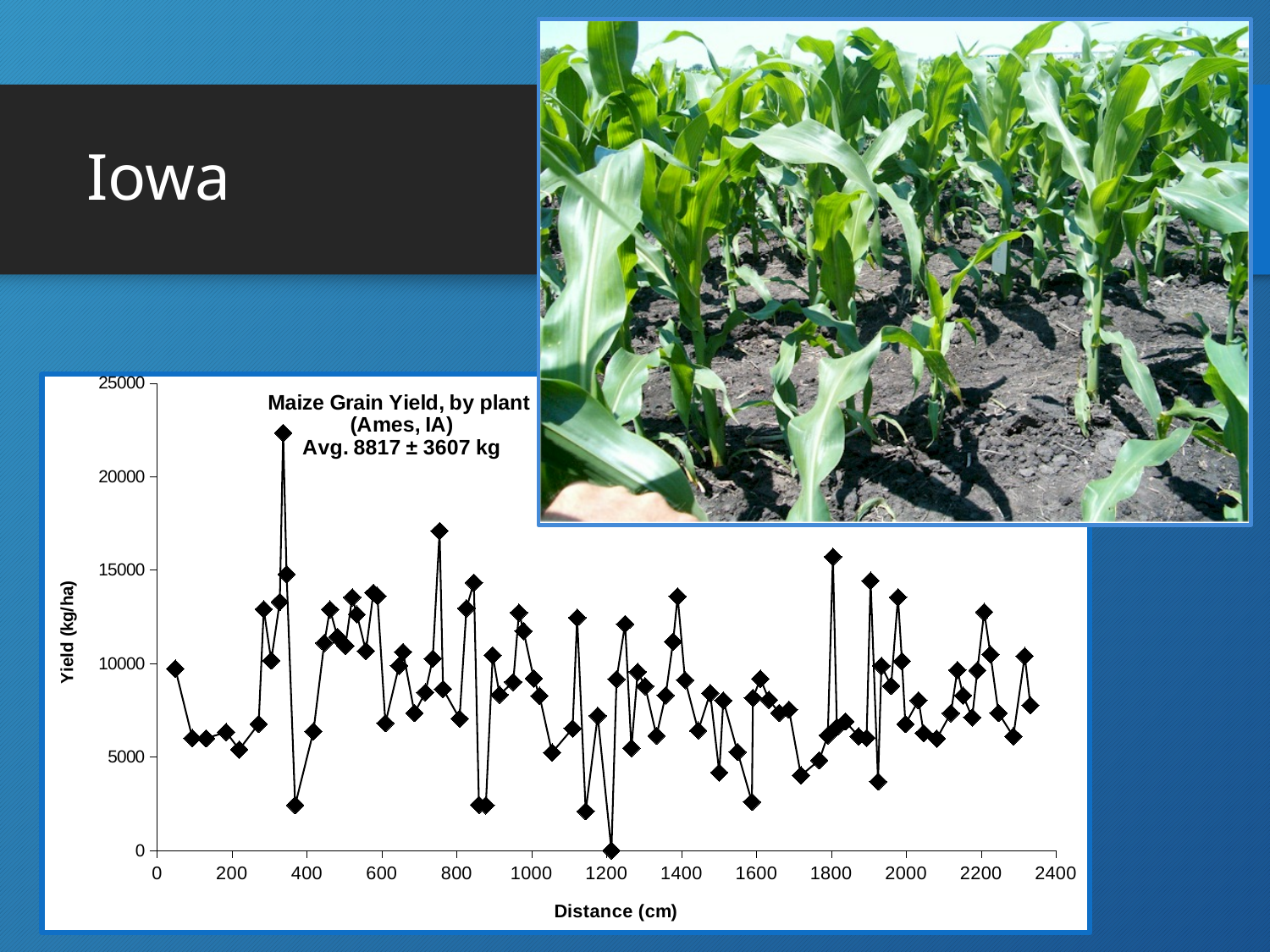
What is the lowest yield value plotted on the chart? 0 Is the yield at the first plotted point (near 50 cm) greater or less than 15000? less Is the yield at the last plotted point (near 2330 cm) greater or less than 10000? less What is the title of the chart? Maize Grain Yield, by plant (Ames, IA) Avg. 8817 ± 3607 kg What average yield is printed on the chart? 8817 ± 3607 kg What is the label of the y axis of the chart? Yield (kg/ha) Is the highest plotted yield value greater or less than 20000? greater Is the highest plotted yield value located before or after 1200 cm on the x axis? before What kind of chart is shown on the slide? line chart Do the yield values show a steady rise, a steady fall, or fluctuate along the distance axis? fluctuate